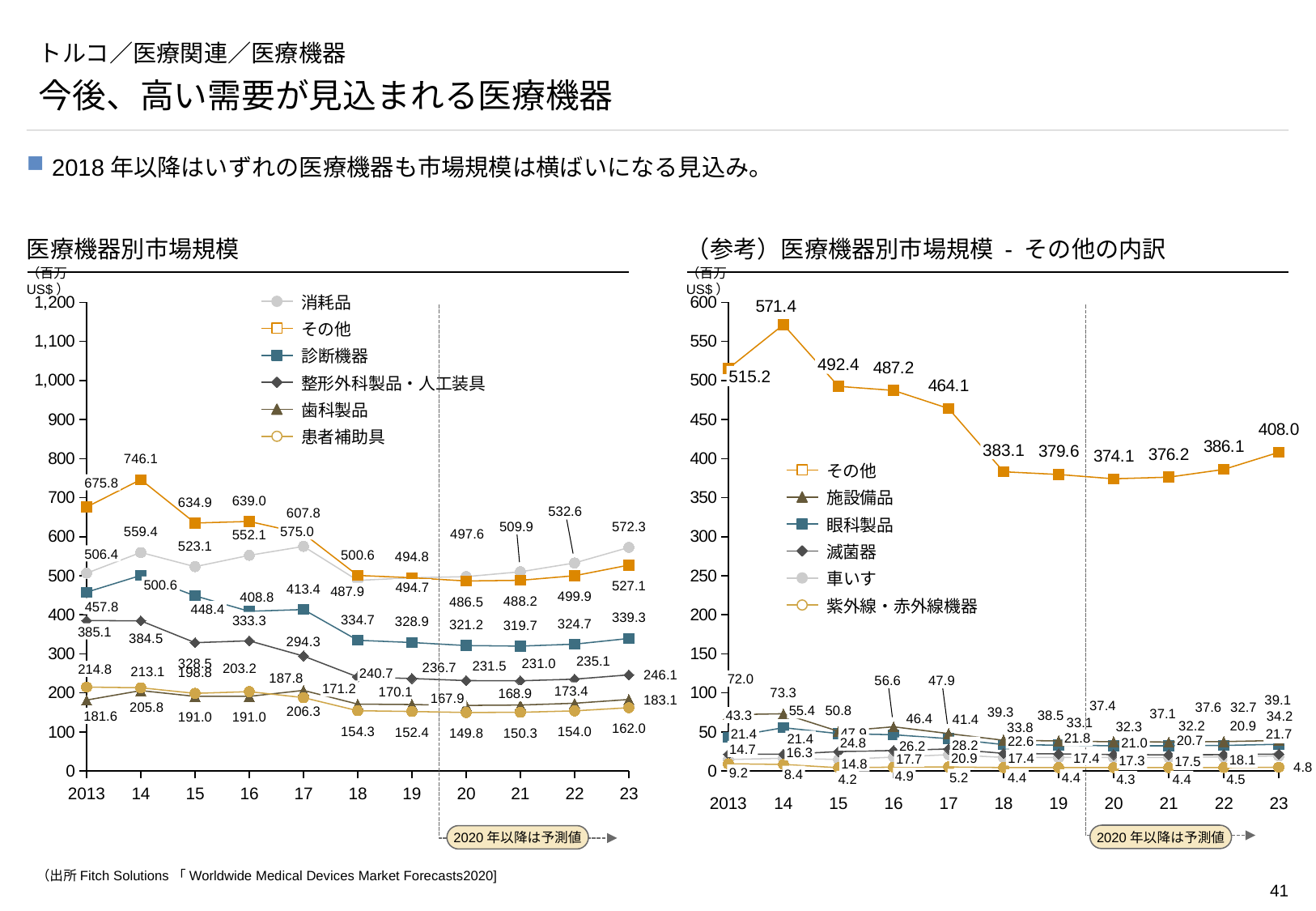
In the left chart (医療機器別市場規模), what is the difference between the 診断機器 values in 2013 and 2023? 118.5 In the right chart (医療機器別市場規模 - その他の内訳), is the value for その他 in 2023 greater or less than 400? greater In the left chart (医療機器別市場規模), in which year is the value for その他 highest? 2014 In the left chart (医療機器別市場規模), what is the value for その他 in 2014? 746.1 In the left chart (医療機器別市場規模), does the value for 診断機器 rise or fall from 2014 to 2021? fall In the left chart (医療機器別市場規模), which is larger in 2013, 診断機器 or 整形外科製品・人工装具? 診断機器 What kind of chart is the left chart titled 医療機器別市場規模? line chart In the right chart (医療機器別市場規模 - その他の内訳), what is the value for その他 in 2014? 571.4 In the right chart (医療機器別市場規模 - その他の内訳), how many years are plotted on the x axis? 11 In the right chart (医療機器別市場規模 - その他の内訳), in which year is the value for その他 lowest? 2020 In the left chart (医療機器別市場規模), what is the value for 診断機器 in 2013? 457.8 In the left chart (医療機器別市場規模), how many series does the legend list? 6